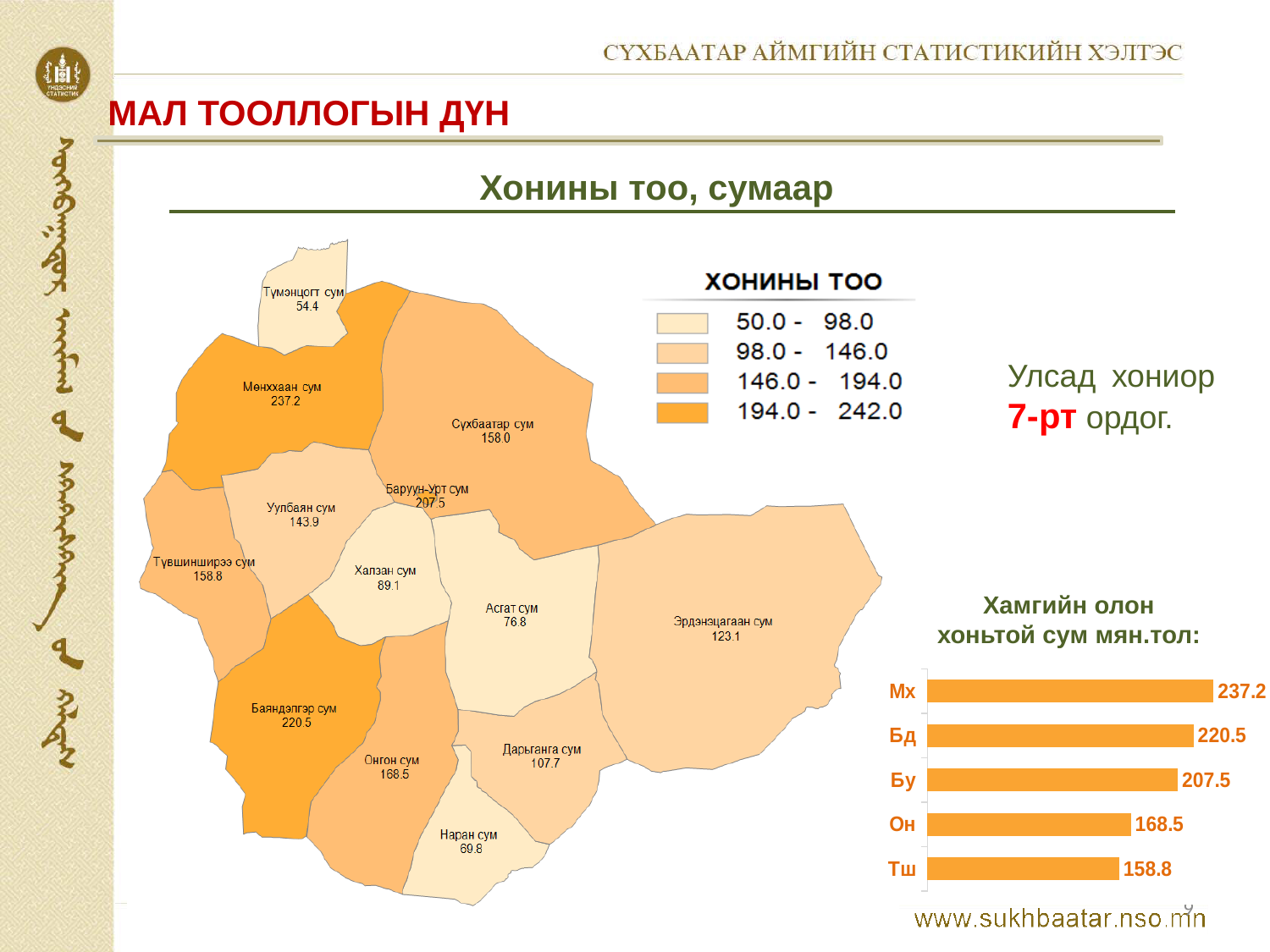
In the bar chart titled 'Хамгийн олон хоньтой сум мян.тол:', what is the value for Мх? 237.2 On the map titled 'Хонины тоо', how many value ranges does the legend list? 4 What kind of chart is the chart titled 'Хамгийн олон хоньтой сум мян.тол:'? bar chart In the bar chart titled 'Хамгийн олон хоньтой сум мян.тол:', which category has the lowest value? Тш In the bar chart titled 'Хамгийн олон хоньтой сум мян.тол:', what is the value for Тш? 158.8 In the bar chart titled 'Хамгийн олон хоньтой сум мян.тол:', which category has the highest value? Мх In the bar chart titled 'Хамгийн олон хоньтой сум мян.тол:', what is the difference between the values for Мх and Бд? 16.7 On the map titled 'Хонины тоо', what value is shown for Баяндэлгэр сум? 220.5 In the bar chart titled 'Хамгийн олон хоньтой сум мян.тол:', what is the value for Бу? 207.5 In the bar chart titled 'Хамгийн олон хоньтой сум мян.тол:', which is larger, the value for Бд or the value for Бу? Бд How many categories are shown in the bar chart titled 'Хамгийн олон хоньтой сум мян.тол:'? 5 In the bar chart titled 'Хамгийн олон хоньтой сум мян.тол:', what is the difference between the values for Он and Тш? 9.7